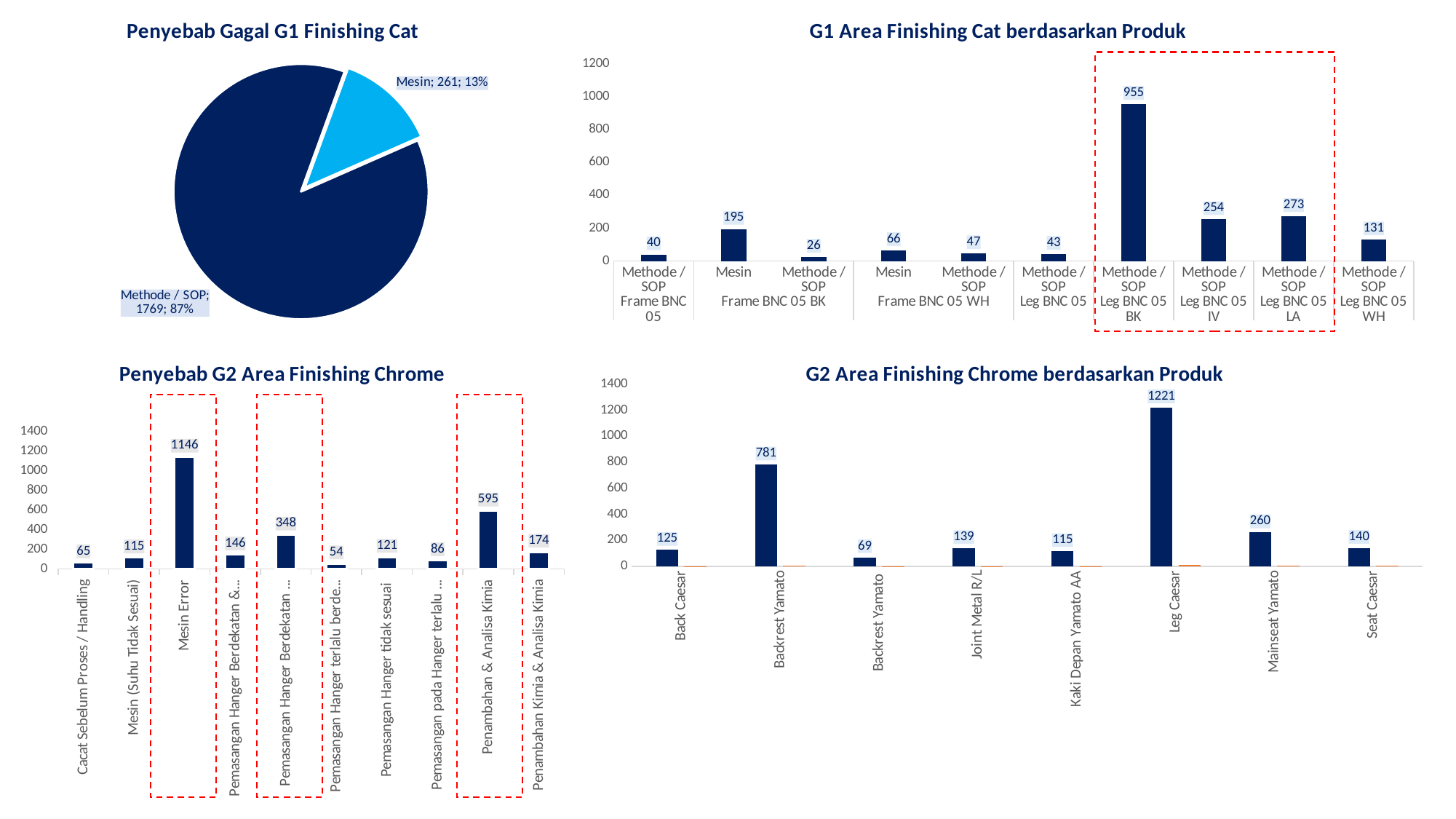
In the 'Penyebab Gagal G1 Finishing Cat' pie chart, what share does Methode / SOP have? 87% In the 'G2 Area Finishing Chrome berdasarkan Produk' chart, which product has the highest value? Leg Caesar In the 'Penyebab G2 Area Finishing Chrome' chart, which is larger: Penambahan & Analisa Kimia or Penambahan Kimia & Analisa Kimia? Penambahan & Analisa Kimia In the 'Penyebab G2 Area Finishing Chrome' chart, what is the value for Mesin Error? 1146 In the 'G2 Area Finishing Chrome berdasarkan Produk' chart, what is the difference between Seat Caesar and Back Caesar? 15 In the 'G2 Area Finishing Chrome berdasarkan Produk' chart, what is the value for Mainseat Yamato? 260 In the 'G1 Area Finishing Cat berdasarkan Produk' chart, what is the difference between Methode / SOP for Leg BNC 05 LA and Leg BNC 05 IV? 19 What kind of chart is 'Penyebab Gagal G1 Finishing Cat'? pie chart In the 'G1 Area Finishing Cat berdasarkan Produk' chart, what is the value for Methode / SOP under Leg BNC 05 BK? 955 How many categories are shown in the 'Penyebab G2 Area Finishing Chrome' chart? 10 In the 'G1 Area Finishing Cat berdasarkan Produk' chart, which bar is the lowest? Methode / SOP, Frame BNC 05 BK In the 'Penyebab Gagal G1 Finishing Cat' pie chart, what value is shown for Mesin? 261